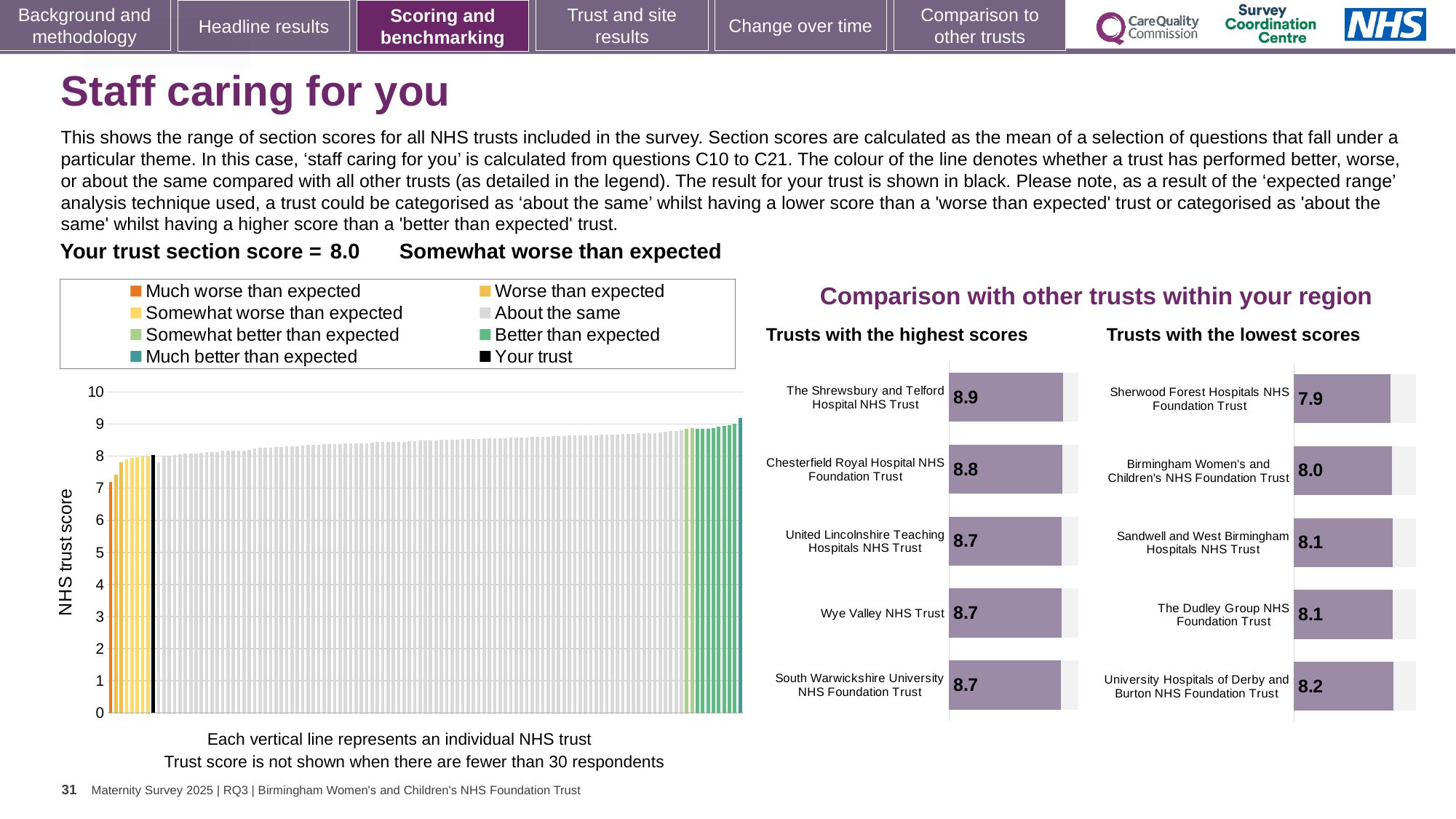
How many entries does the legend above the main chart on the left list? 8 In the 'Trusts with the lowest scores' chart, which has the larger score: Sherwood Forest Hospitals NHS Foundation Trust or Sandwell and West Birmingham Hospitals NHS Trust? Sandwell and West Birmingham Hospitals NHS Trust In the 'Trusts with the highest scores' chart, what is the difference between the scores of The Shrewsbury and Telford Hospital NHS Trust and Wye Valley NHS Trust? 0.2 In the 'Trusts with the lowest scores' chart, what is the score for University Hospitals of Derby and Burton NHS Foundation Trust? 8.2 In the 'Trusts with the highest scores' chart, what is the score for The Shrewsbury and Telford Hospital NHS Trust? 8.9 In the 'Trusts with the lowest scores' chart, what is the score for Sherwood Forest Hospitals NHS Foundation Trust? 7.9 In the main chart on the left, is the value of the leftmost (orange) bar greater or less than 8? less What type of chart is the main chart on the left of the slide? bar chart In the 'Trusts with the lowest scores' chart, which trust has the lowest score? Sherwood Forest Hospitals NHS Foundation Trust In the main chart on the left, what is the section score for your trust (shown in black)? 8.0 In the 'Trusts with the highest scores' chart, which trust has the highest score? The Shrewsbury and Telford Hospital NHS Trust How many trusts are listed in the 'Trusts with the highest scores' chart? 5